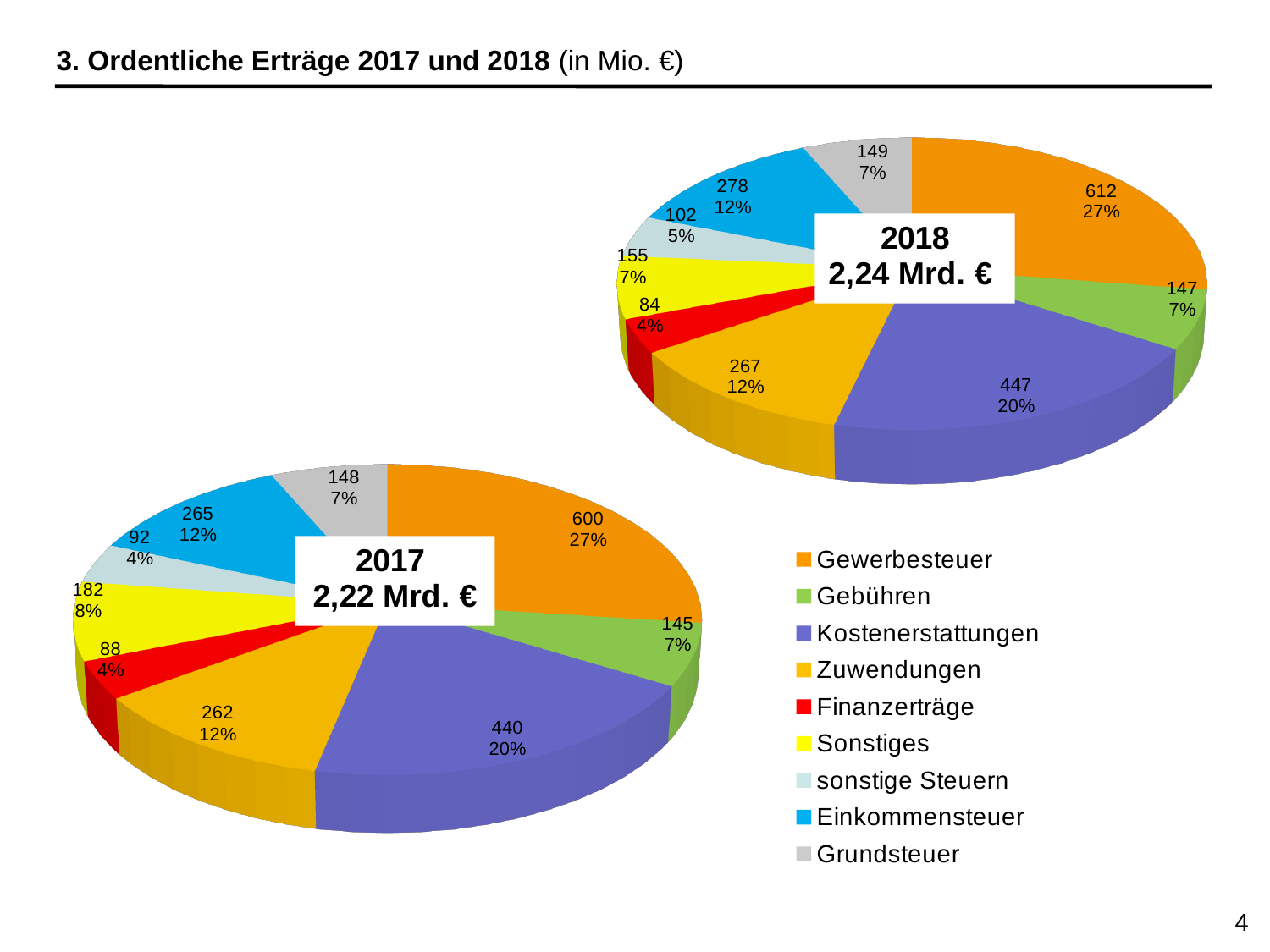
What is the difference between the Gewerbesteuer value in the 2018 pie chart and the Gewerbesteuer value in the 2017 pie chart? 12 What total is shown in the centre of the 2018 pie chart? 2,24 Mrd. € In the 2017 pie chart, which is larger: Zuwendungen or Einkommensteuer? Einkommensteuer In the 2018 pie chart, what is the value for Gewerbesteuer? 612 Which colour represents Kostenerstattungen in the legend? Purple In the 2017 pie chart, what is the value for Kostenerstattungen? 440 How many categories does the legend list? 9 In the 2018 pie chart, what share of the pie does Einkommensteuer have? 12% In the 2017 pie chart, what share of the pie does Sonstiges have? 8% What kind of chart is used for the 2017 and 2018 data? Pie chart In the 2017 pie chart, which category has the smallest value? Finanzerträge In the 2018 pie chart, which category has the largest value? Gewerbesteuer